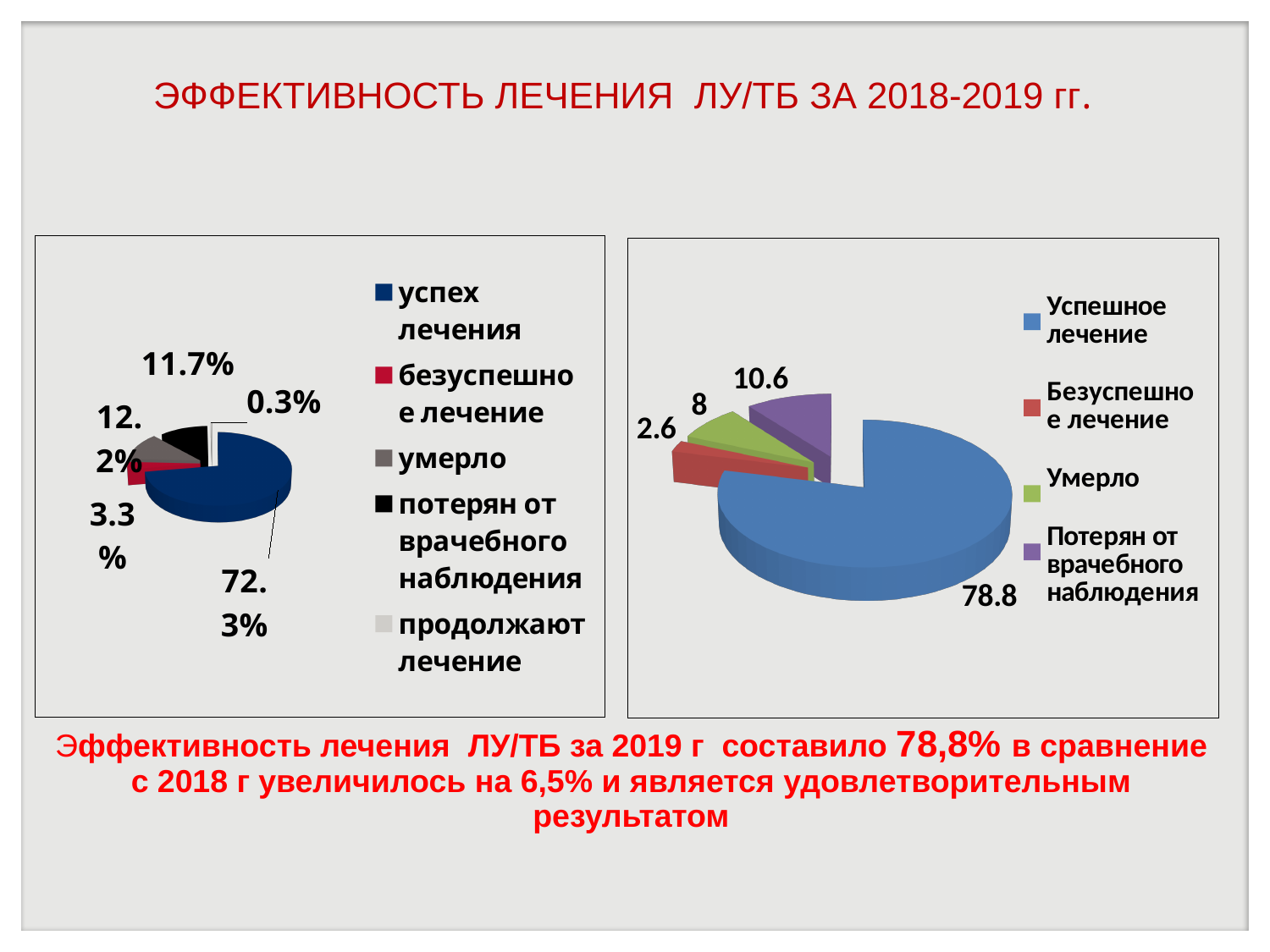
In the left pie chart, what is the value for потерян от врачебного наблюдения? 11.7% In the right pie chart, what is the value for Умерло? 8 In the right pie chart, what is the value for Безуспешное лечение? 2.6 In the right pie chart, what is the difference between the values for Потерян от врачебного наблюдения and Умерло? 2.6 In the left pie chart, what is the value for продолжают лечение? 0.3% In the left pie chart, which category has the smallest slice? продолжают лечение In the right pie chart, what is the value for Успешное лечение? 78.8 In the right pie chart, which colour represents Умерло? green In the right pie chart, which category has the largest slice? Успешное лечение In the left pie chart, what is the value for успех лечения? 72.3% What kind of chart is the chart on the left of the slide? pie chart How many categories does the legend of the left pie chart list? 5